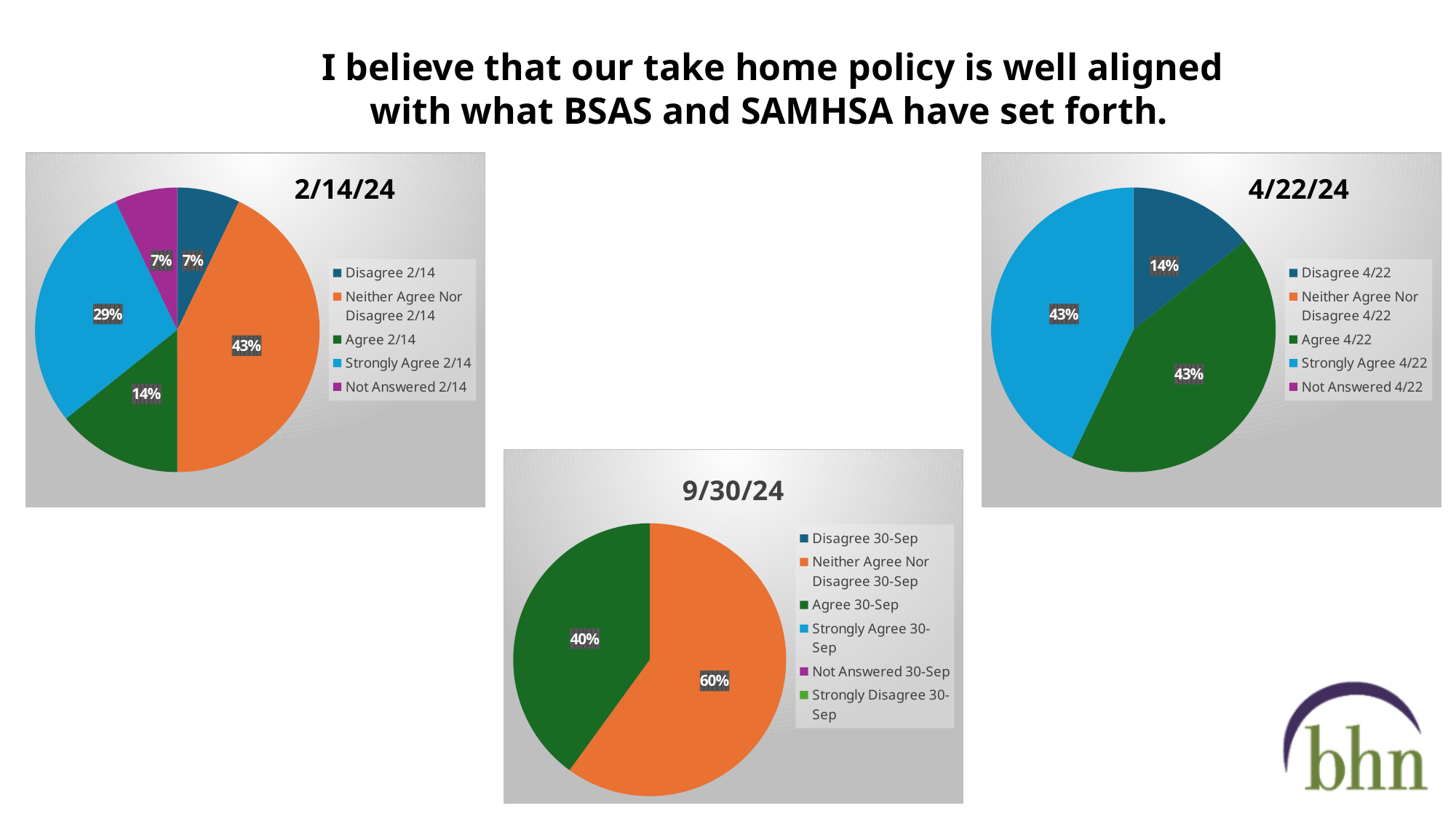
What type of chart is used for the 2/14/24 data? Pie chart In the 9/30/24 pie chart, which is larger, Agree or Neither Agree Nor Disagree? Neither Agree Nor Disagree In the 2/14/24 pie chart, what percentage is Strongly Agree? 29% In the 4/22/24 pie chart, what percentage is Disagree? 14% How many entries does the legend of the 9/30/24 chart list? 6 In the 4/22/24 pie chart, which category has the smallest share? Disagree In the 2/14/24 pie chart, which category has the largest share? Neither Agree Nor Disagree In the 9/30/24 pie chart, what percentage is Neither Agree Nor Disagree? 60% In the 2/14/24 pie chart, what percentage is Neither Agree Nor Disagree? 43% In the 2/14/24 pie chart, what is the difference between the Strongly Agree and Agree shares? 15% In the 4/22/24 pie chart, what percentage is Agree? 43% In the 9/30/24 pie chart, what is the difference between the Neither Agree Nor Disagree and Agree shares? 20%